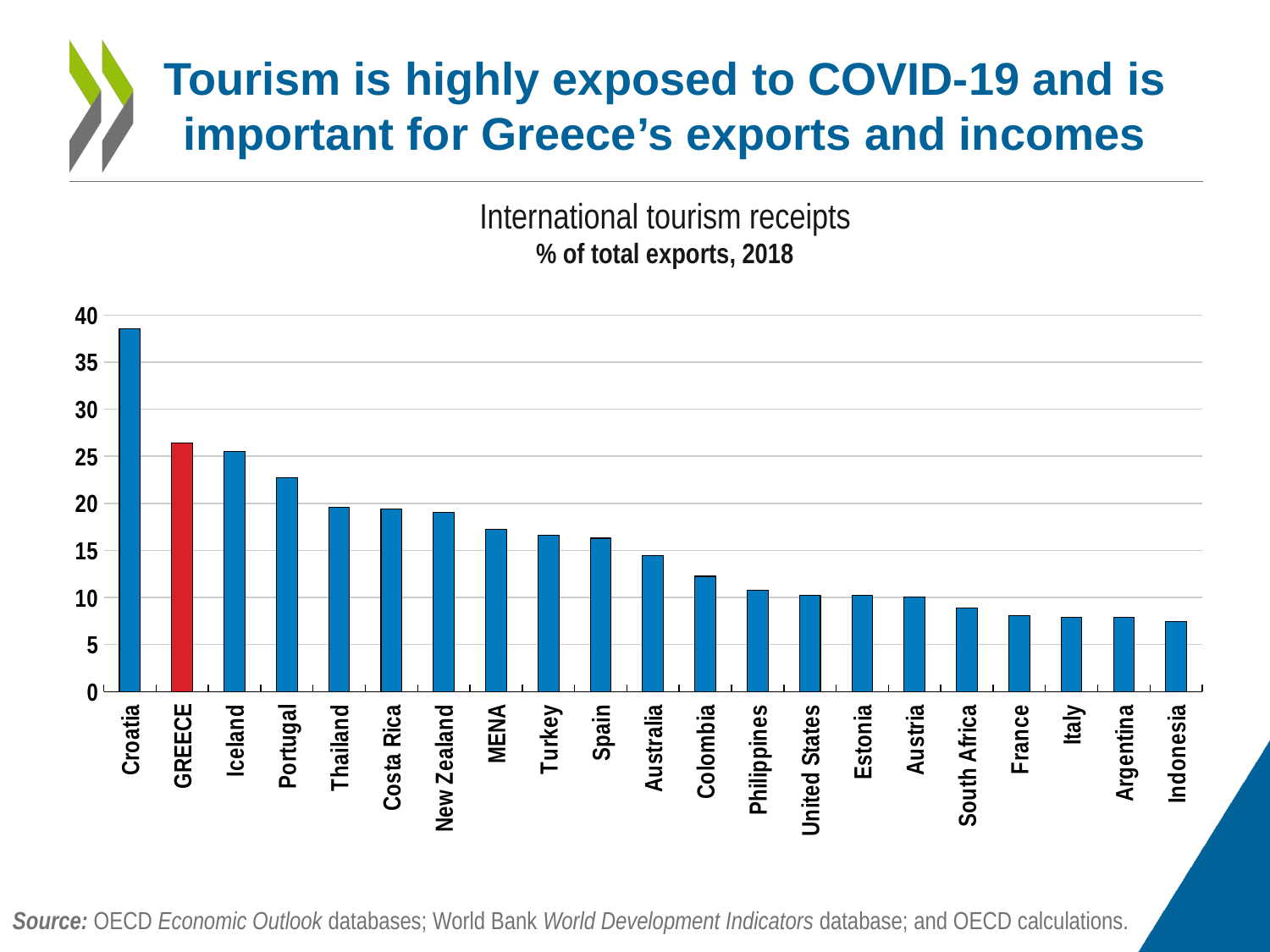
Which country has the highest international tourism receipts as a % of total exports? Croatia How many countries or regions are shown on the x axis? 21 Which country has the lowest international tourism receipts as a % of total exports? Indonesia Which bar is coloured red rather than blue? GREECE Is the value for South Africa greater or less than 10? less Which has a larger value, Portugal or Spain? Portugal What kind of chart is shown on the slide? Bar chart Is the value for Croatia greater or less than 35? greater Do the values rise or fall moving from left to right along the x axis? Fall Is the value for GREECE greater or less than 25? greater